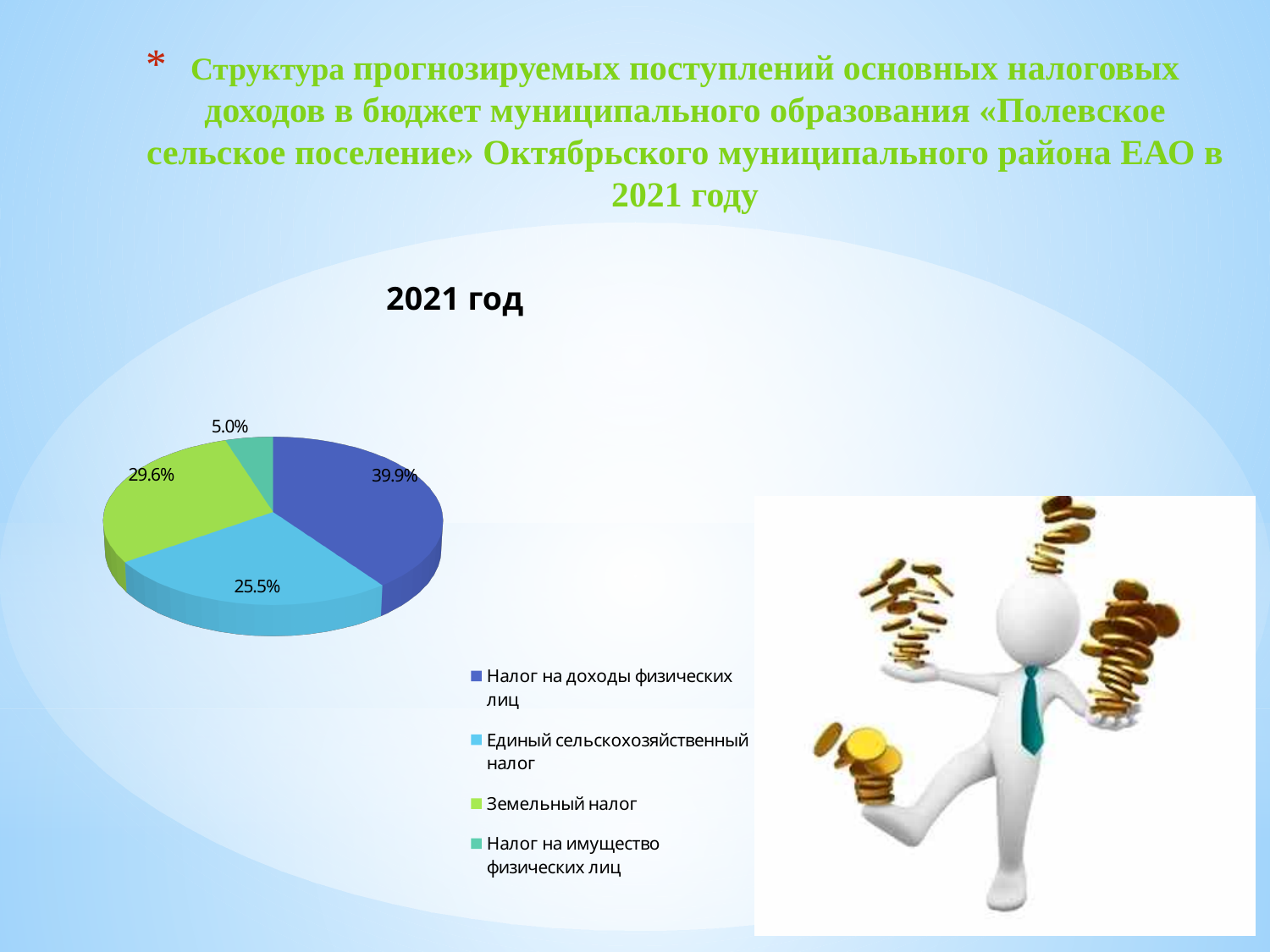
What share of the pie does Налог на доходы физических лиц have? 39.9% Which category has the largest slice of the pie? Налог на доходы физических лиц What share of the pie does Единый сельскохозяйственный налог have? 25.5% What share of the pie does Налог на имущество физических лиц have? 5.0% What is the chart's title? 2021 год What kind of chart is shown on the slide? Pie chart Which category has the smallest slice of the pie? Налог на имущество физических лиц How many categories does the legend list? 4 What colour is the slice for Земельный налог? Green Which is larger: the share for Земельный налог or the share for Единый сельскохозяйственный налог? Земельный налог What is the difference in percentage points between Налог на доходы физических лиц and Земельный налог? 10.3 What share of the pie does Земельный налог have? 29.6%